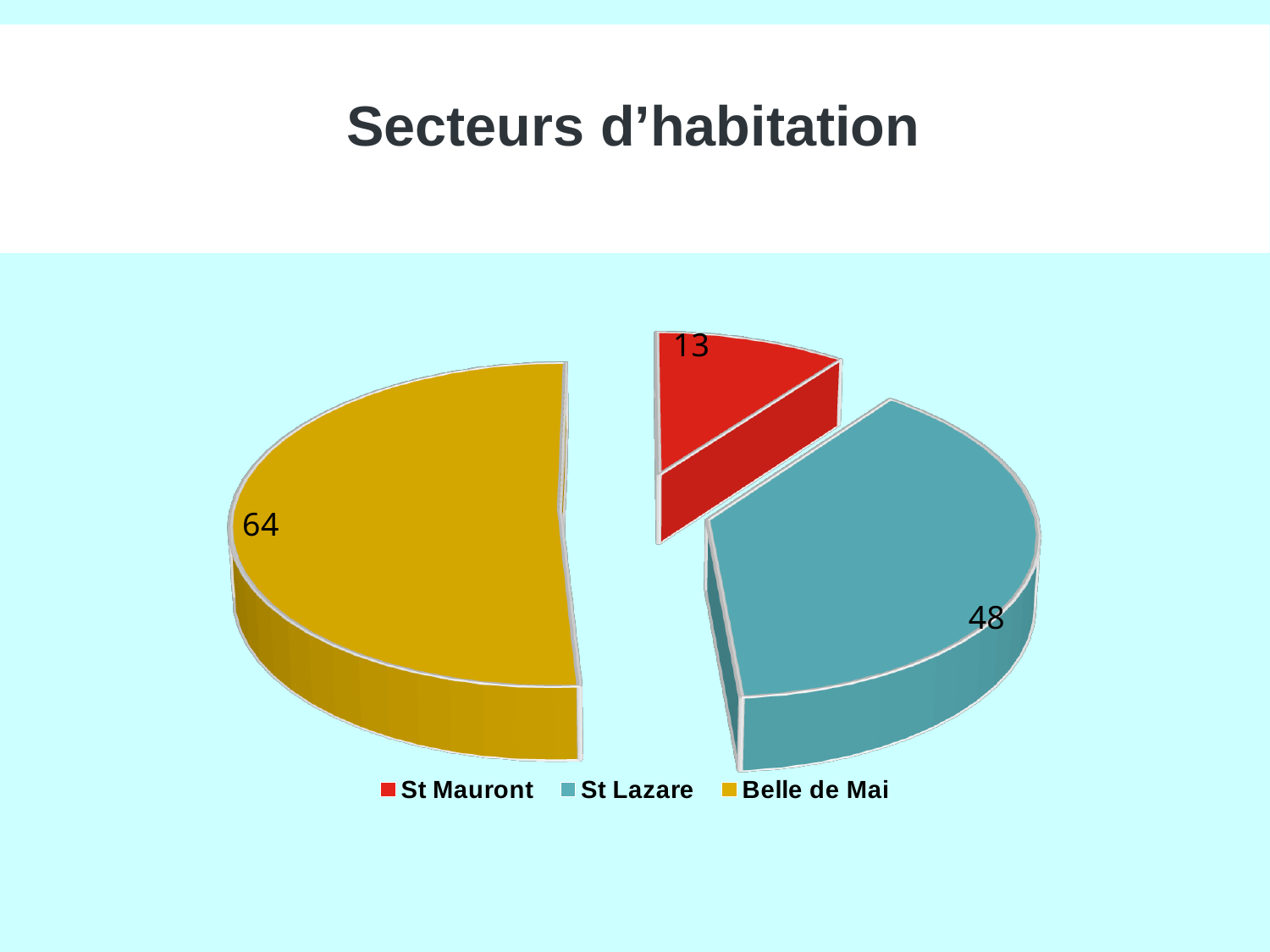
Which sector has the smallest slice? St Mauront What is the difference between the values for St Lazare and St Mauront? 35 What is the total of all the slices in the pie chart? 125 What is the value for Belle de Mai? 64 What kind of chart is shown on the slide? pie chart What is the difference between the values for Belle de Mai and St Lazare? 16 Which sector has the largest slice? Belle de Mai Which is larger, the value for St Lazare or the value for St Mauront? St Lazare What is the value for St Mauront? 13 What is the value for St Lazare? 48 What is the title of the chart? Secteurs d'habitation How many slices does the pie chart have? 3